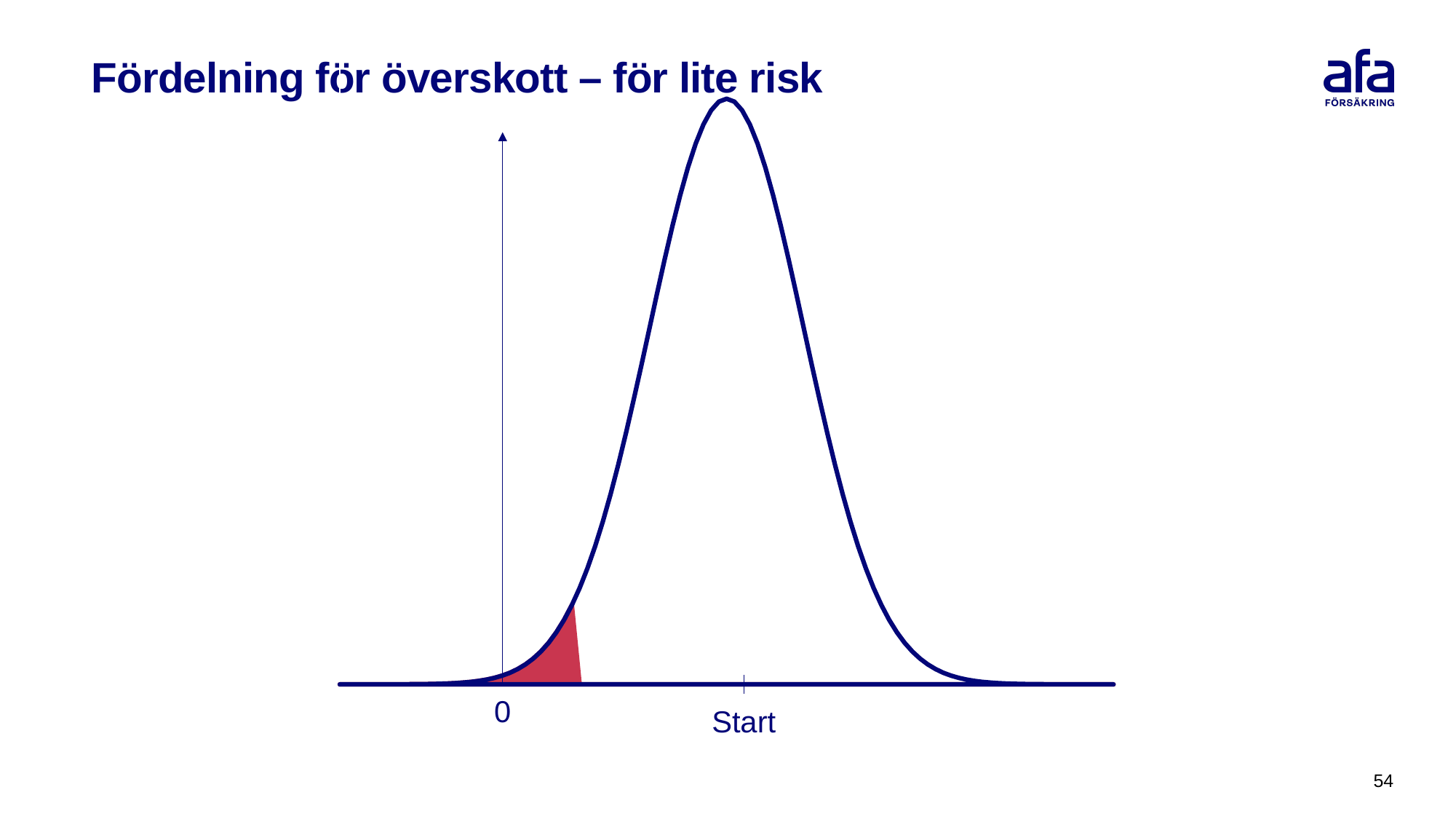
Does the curve rise or fall as it moves from 0 towards Start along the x axis? rise What colour is the shaded area under the left tail of the curve? red What is the title of the chart on the slide? Fördelning för överskott – för lite risk How many labels are printed along the x axis of the chart? 2 Does the curve rise or fall as it moves to the right of Start along the x axis? fall What kind of chart is shown on the slide? line chart Is the curve higher at Start or at 0? Start At which x-axis label does the curve reach its highest point? Start